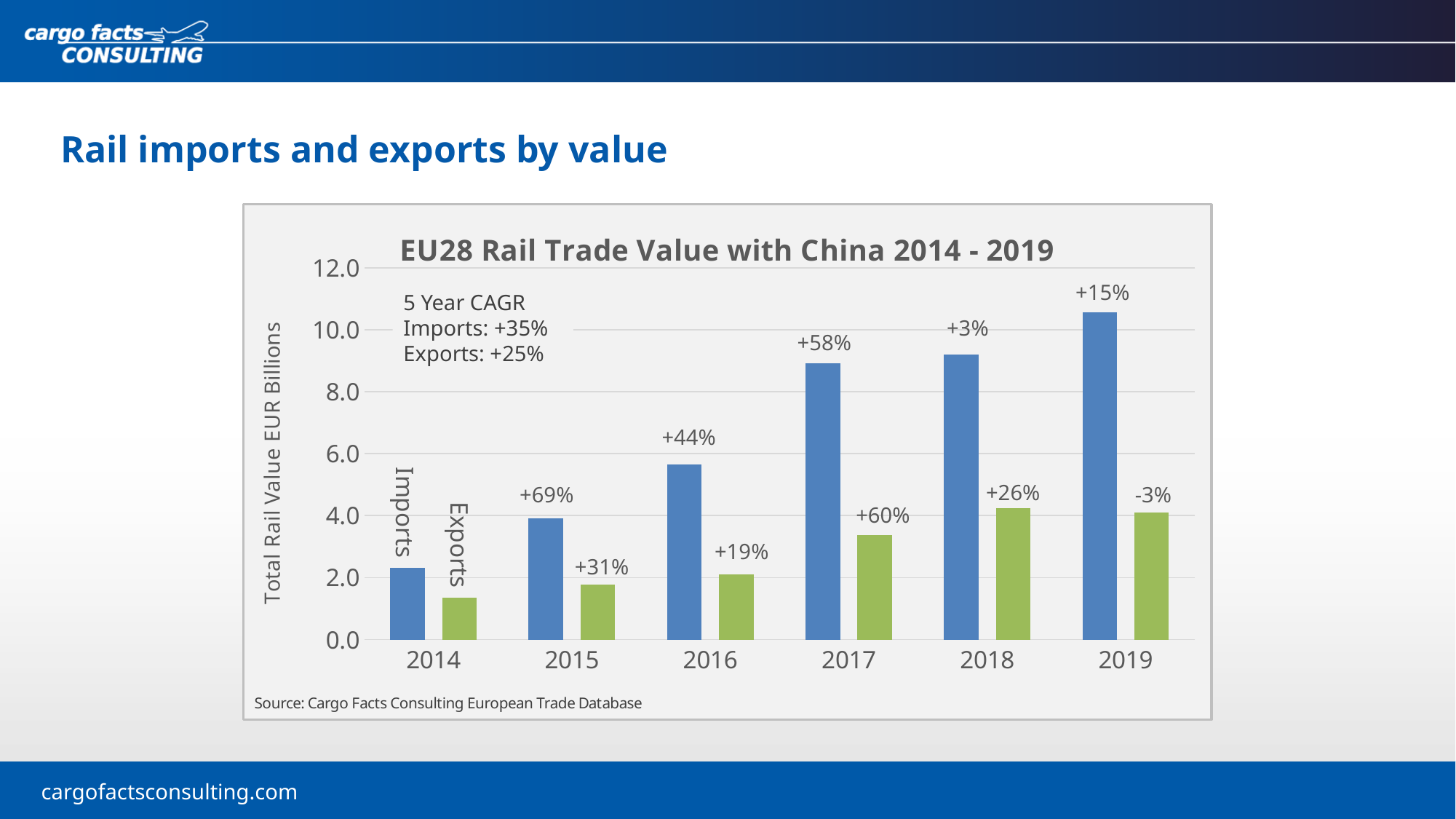
What growth percentage is labelled above the Imports bar for 2017? +58% How many years are shown on the x axis of the chart? 6 Is the value for Imports in 2019 greater or less than 10.0? greater In which year is the Exports bar lowest? 2014 How many data series does the chart show? 2 Do Imports rise or fall from 2014 to 2019? Rise What is the 5 year CAGR for Imports stated on the chart? +35% In 2017, which is larger, Imports or Exports? Imports What type of chart is shown on the slide? Bar chart What growth percentage is labelled above the Exports bar for 2019? -3% What is the title of the chart? EU28 Rail Trade Value with China 2014 - 2019 In which year is the Imports bar highest? 2019